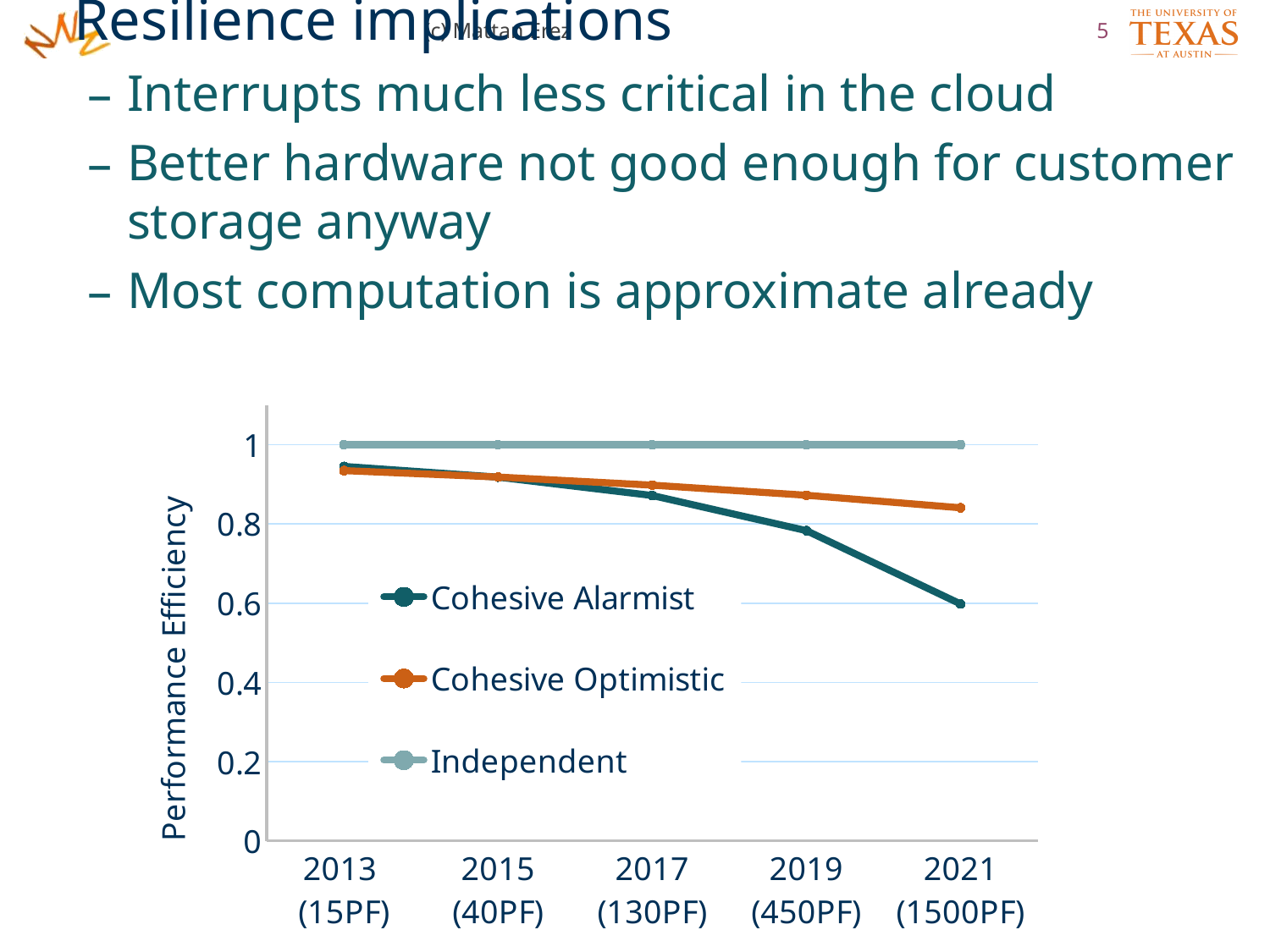
What is the label of the y axis? Performance Efficiency Which series has the lowest Performance Efficiency in 2021 (1500PF)? Cohesive Alarmist What is the Performance Efficiency of the Independent series in 2013 (15PF)? 1 In 2021 (1500PF), which is larger: Cohesive Optimistic or Cohesive Alarmist? Cohesive Optimistic What kind of chart is shown on the slide? line chart How many series does the legend list? 3 Does the Cohesive Alarmist series rise or fall from 2013 to 2021? fall How many years are plotted along the x axis? 5 Is the value for Cohesive Alarmist in 2013 (15PF) greater or less than 0.8? greater Is the value for Cohesive Optimistic in 2021 (1500PF) greater or less than 0.8? greater